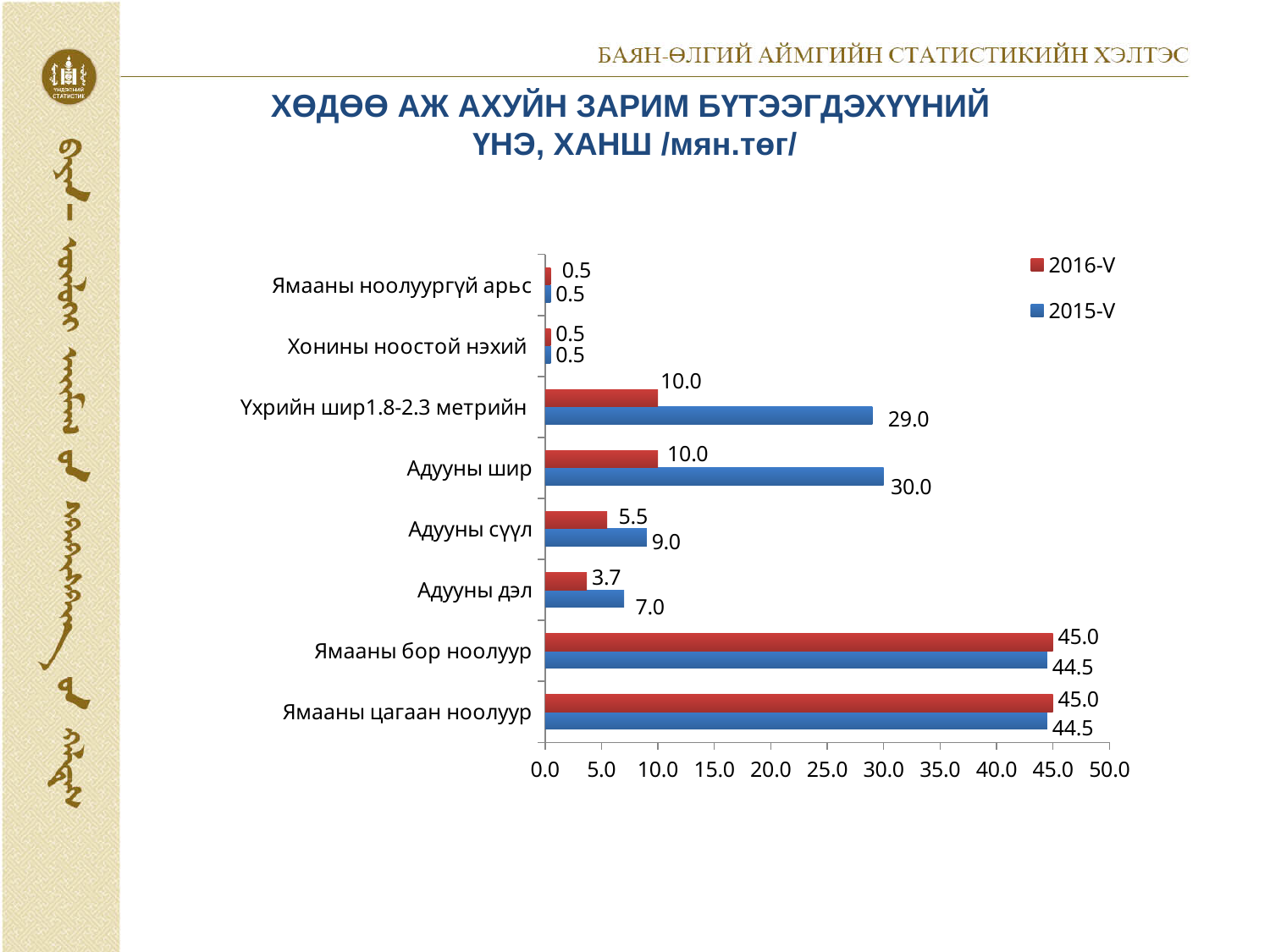
What kind of chart is shown on the slide? bar chart Which is larger for Адууны сүүл, the 2015-V value or the 2016-V value? 2015-V Which category has the lowest 2015-V value? Ямааны ноолуургүй арьс and Хонины ноостой нэхий (both 0.5) What is the difference between the 2016-V and 2015-V values for Ямааны бор ноолуур? 0.5 What is the difference between the 2015-V and 2016-V values for Адууны шир? 20.0 What is the 2016-V value for Адууны сүүл? 5.5 What is the 2015-V value for Адууны шир? 30.0 What is the 2015-V value for Үхрийн шир1.8-2.3 метрийн? 29.0 Which colour represents the 2016-V series in the chart? red How many categories are shown on the chart? 8 How many series does the legend list? 2 What is the 2016-V value for Адууны дэл? 3.7